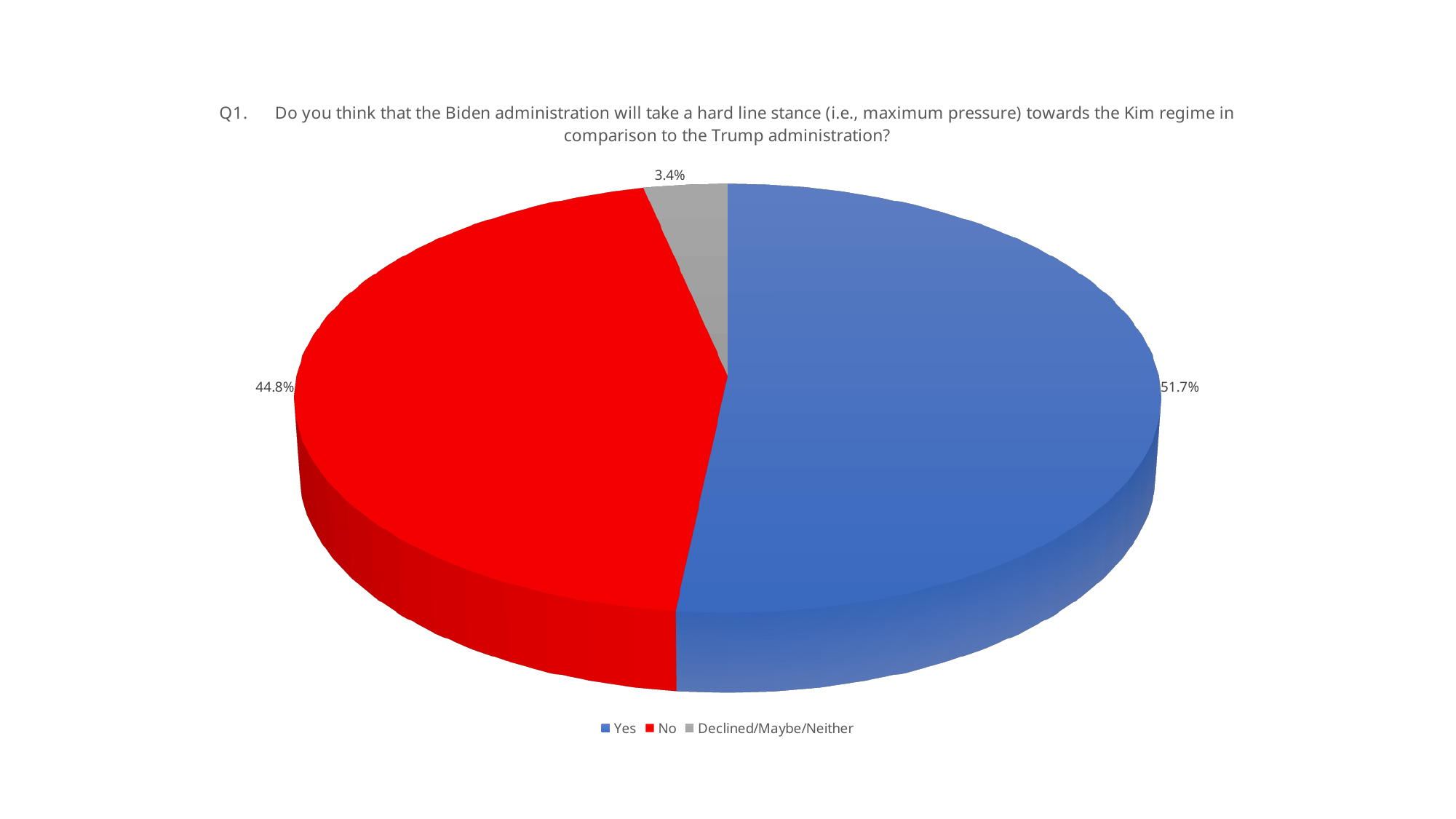
What percentage of respondents answered No? 44.8% What is the share of the pie taken by the Yes slice? 51.7% Which is larger, the share for No or the share for Declined/Maybe/Neither? No Which response has the smallest share of the pie? Declined/Maybe/Neither Which response has the largest share of the pie? Yes What colour represents the No slice? Red How many categories does the pie chart show? 3 What percentage of respondents fall under Declined/Maybe/Neither? 3.4% Which question number is the chart about? Q1 What kind of chart is shown on the slide? Pie chart What percentage of respondents answered Yes? 51.7% What is the difference in percentage points between the Yes and No shares? 6.9